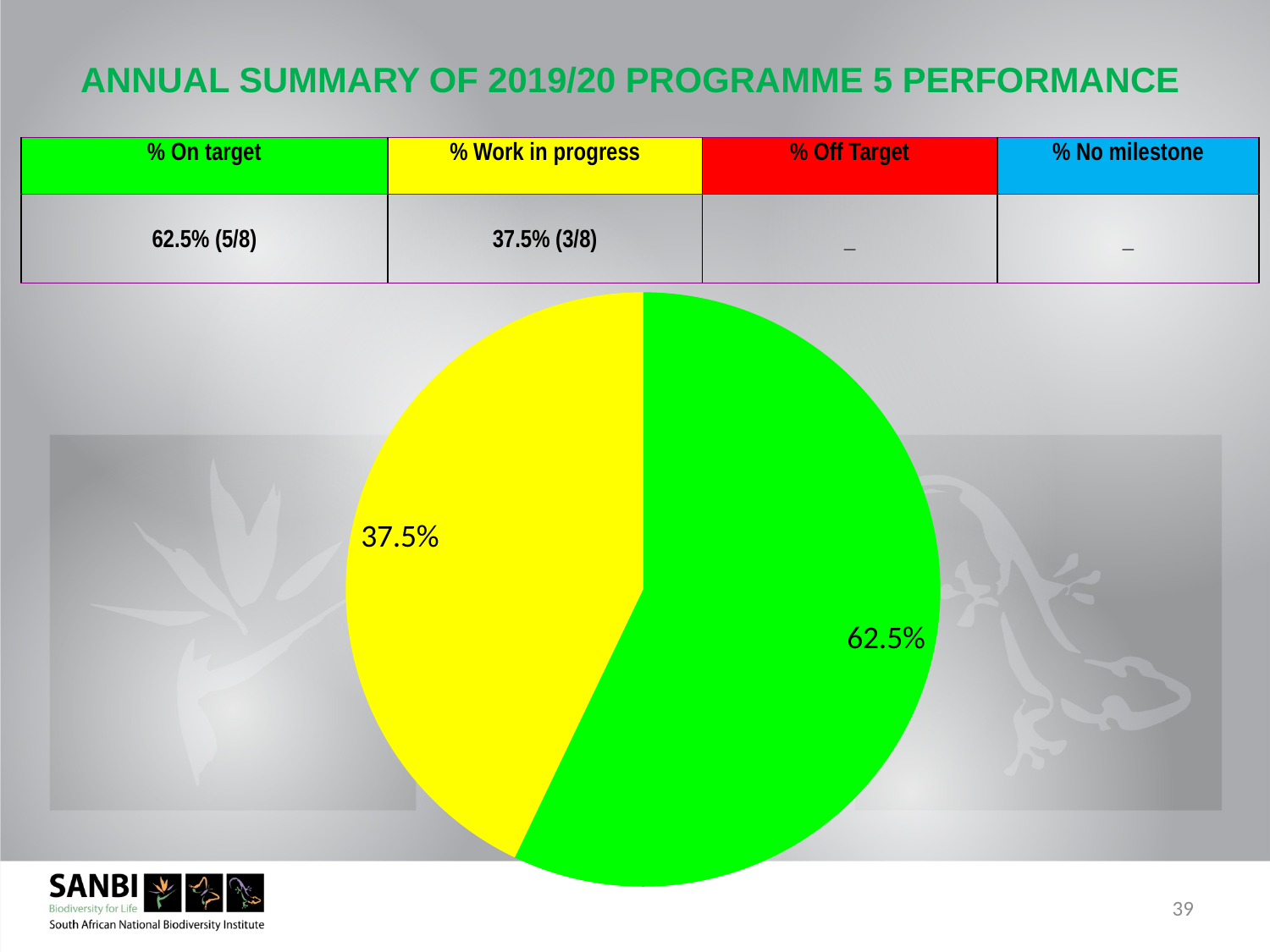
According to the table above the pie chart, which category does the green slice represent? % On target Is the value of the yellow slice greater or less than 50%? less According to the table above the pie chart, which category does the yellow slice represent? % Work in progress How many slices does the pie chart have? 2 What kind of chart is shown on the slide? pie chart What percentage is shown on the green slice of the pie chart? 62.5% Is the green slice or the yellow slice of the pie chart larger? the green slice What is the total of the two slice values shown on the pie chart? 100% What percentage is shown on the yellow slice of the pie chart? 37.5% What is the difference between the two slice values in the pie chart? 25% Which slice of the pie chart is the largest? the green slice (62.5%) Which slice of the pie chart is the smallest? the yellow slice (37.5%)